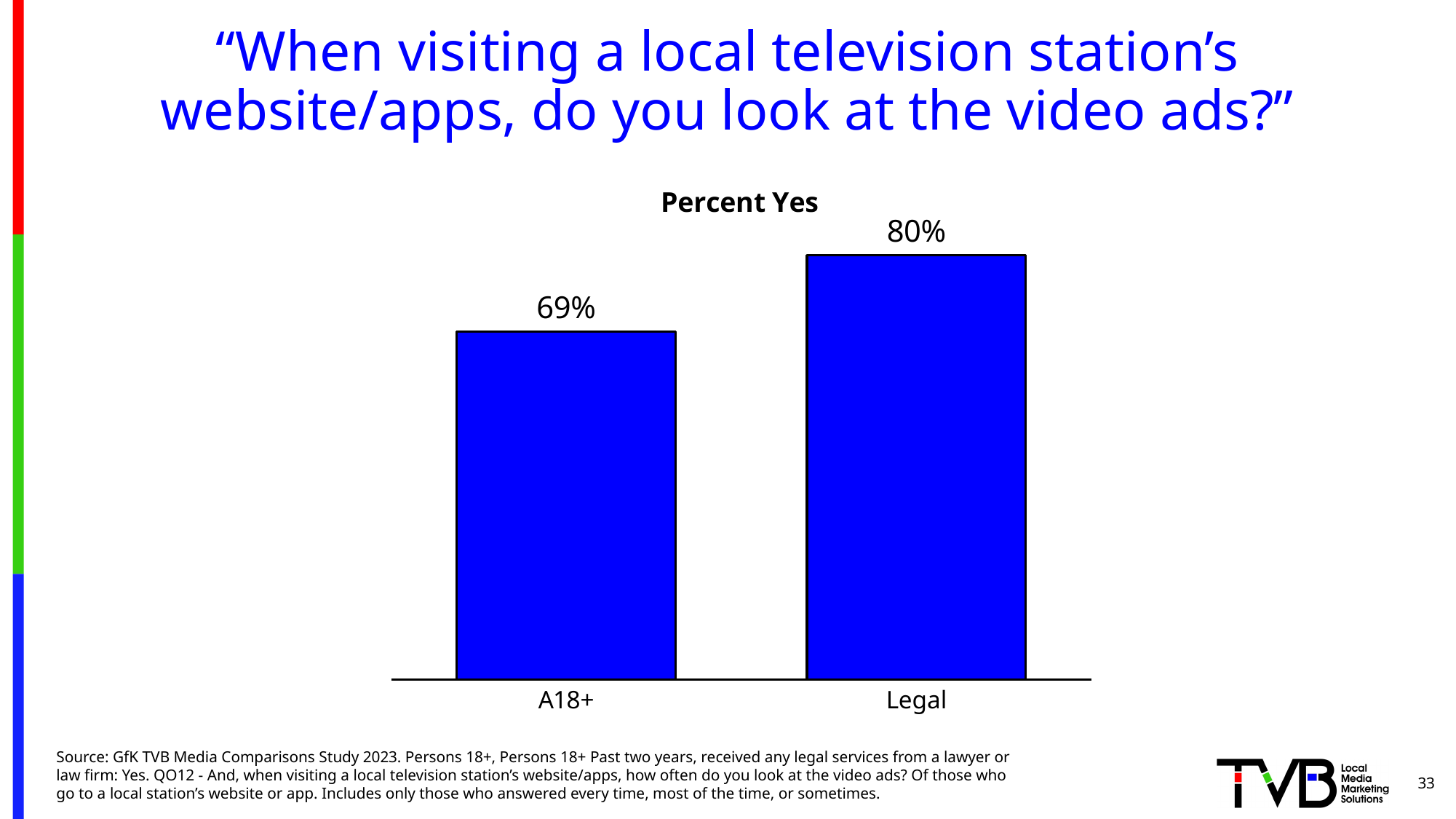
What is the Percent Yes value for A18+? 69% Which category has the higher Percent Yes value? Legal What is the Percent Yes value for Legal? 80% How many categories are shown in the chart? 2 Which category has the lower Percent Yes value? A18+ What colour are the bars in the chart? blue Is the value for Legal larger or smaller than the value for A18+? larger What is the title of the chart? Percent Yes What kind of chart is shown on the slide? bar chart What is the difference in percentage points between the Legal and A18+ values? 11